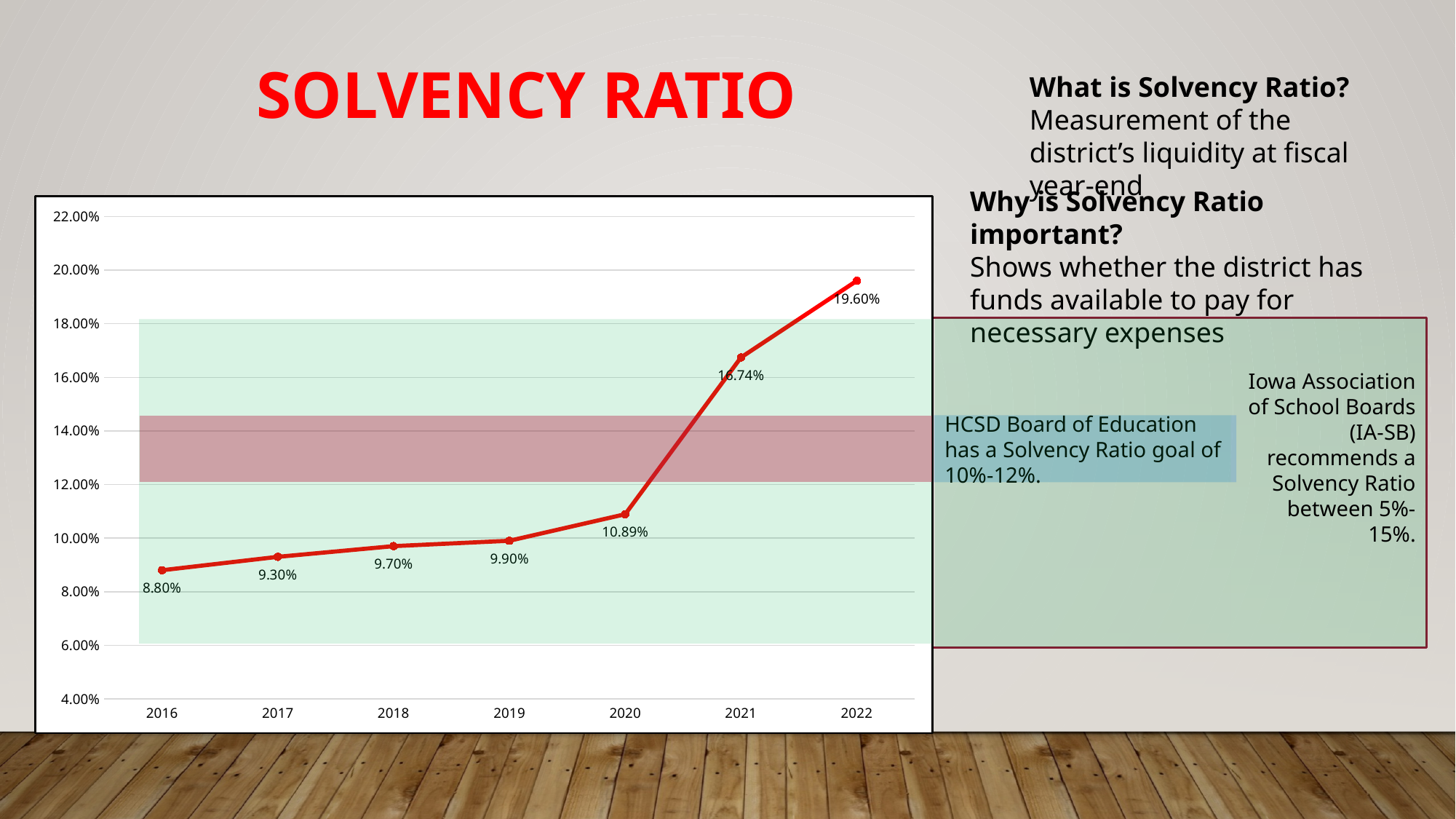
Does the solvency ratio rise or fall from 2016 to 2022? rise How many years are plotted on the chart? 7 Which year has a higher solvency ratio, 2019 or 2021? 2021 What is the solvency ratio for 2020? 10.89% Which year has the highest solvency ratio? 2022 What kind of chart is shown on the slide? line chart Is the solvency ratio for 2021 greater or less than 16.00%? greater Which year has the lowest solvency ratio? 2016 What is the solvency ratio for 2016? 8.80% What is the difference between the solvency ratio in 2022 and in 2021? 2.86% What is the solvency ratio for 2018? 9.70% What is the solvency ratio for 2022? 19.60%